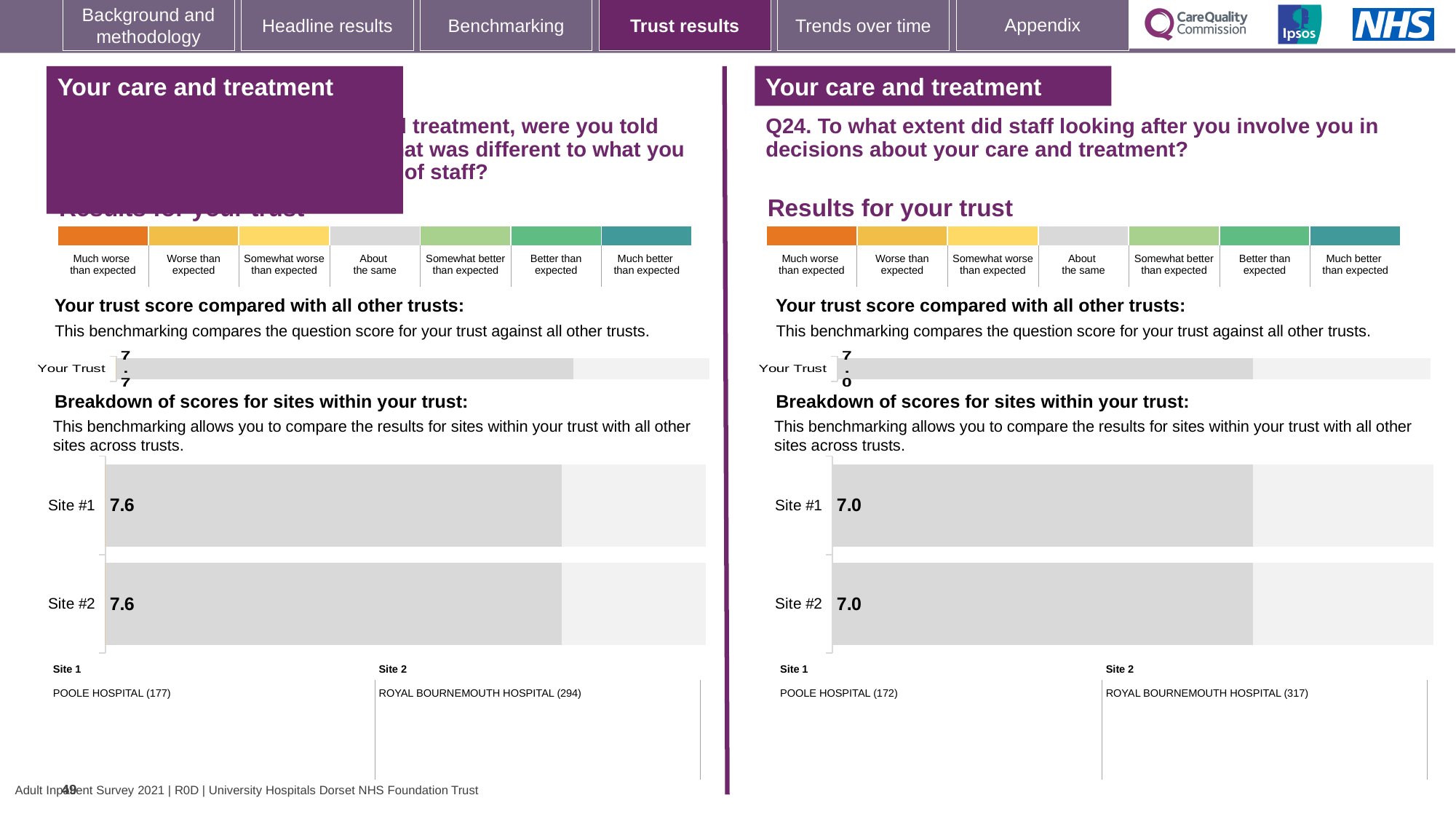
On the left chart, what is the difference between the 'Your Trust' score and the Site #1 score? 0.1 On the Q24 chart (right), what is the score for Site #1? 7.0 On the left chart's breakdown of scores for sites within your trust, what is the score for Site #2? 7.6 On the Q24 chart (right), what is the 'Your Trust' score compared with all other trusts? 7.0 On the left chart, what is the 'Your Trust' score compared with all other trusts? 7.7 On the left chart's breakdown of scores for sites within your trust, what is the score for Site #1? 7.6 On the left chart, do Site #1 and Site #2 have the same score? Yes What kind of chart is used for the breakdown of scores for sites on the Q24 chart (right)? Bar chart On the Q24 chart (right), what is the score for Site #2? 7.0 On the Q24 chart (right), how many sites are shown in the breakdown of scores within your trust? 2 On the left chart, how many sites are shown in the breakdown of scores within your trust? 2 On the Q24 chart (right), which hospital is listed as Site 2? Royal Bournemouth Hospital